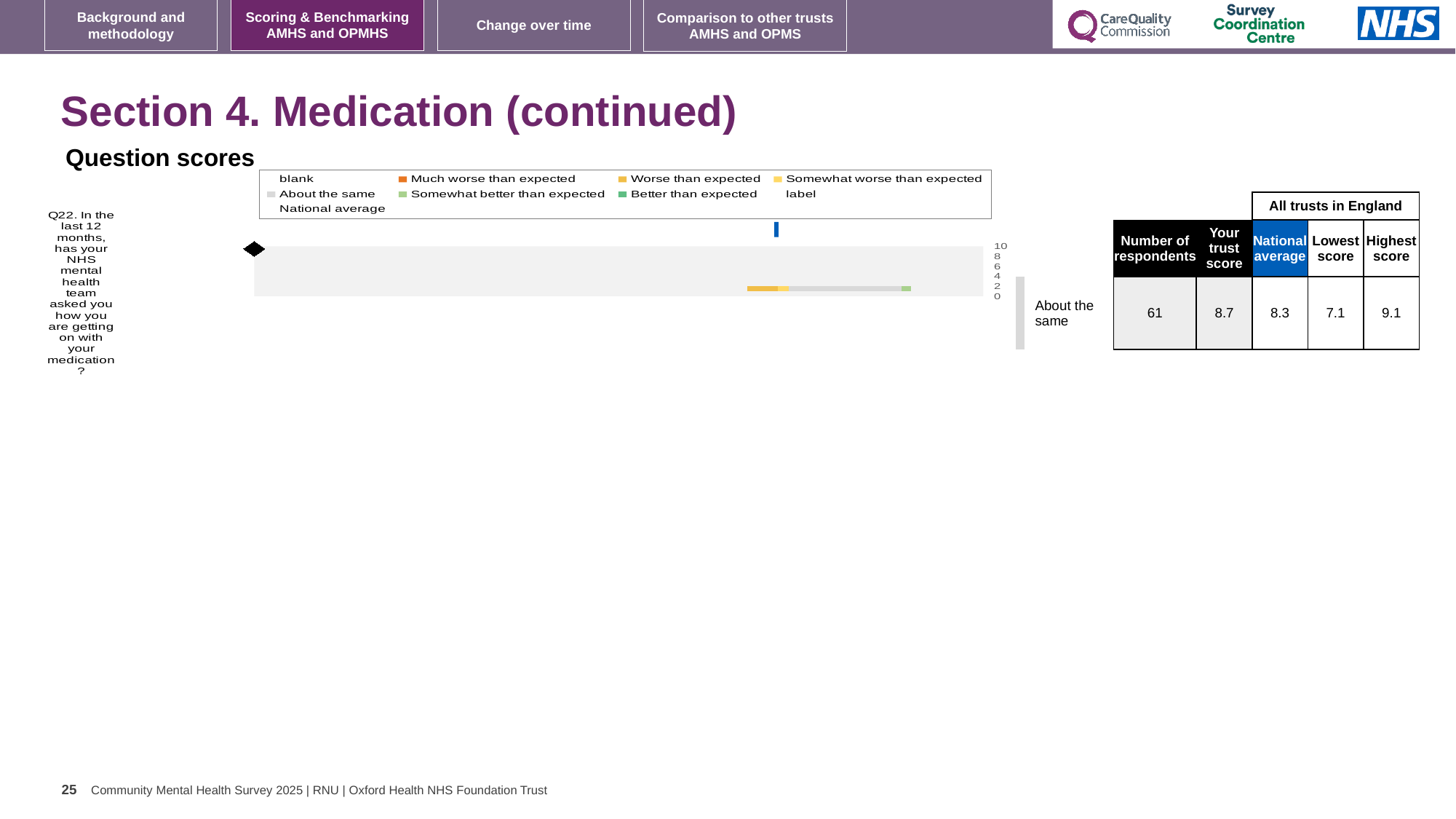
In the table beside the Question scores chart, how many respondents answered Q22? 61 How many survey questions are plotted in the Question scores chart? 1 For Q22, what is the difference between the Highest score and the Lowest score in the table? 2.0 In the legend of the Question scores chart, what colour is used for 'Much worse than expected'? orange In the table beside the Question scores chart, what is the Lowest score for Q22? 7.1 Which benchmark category is shown next to the Q22 bar in the Question scores chart? About the same In the table beside the Question scores chart, what is the 'Your trust score' for Q22? 8.7 How many entries does the legend of the Question scores chart list? 9 In the table beside the Question scores chart, what is the National average for Q22? 8.3 In the table beside the Question scores chart, what is the Highest score for Q22? 9.1 For Q22, which is larger: the trust score or the National average? the trust score What kind of chart is shown under 'Question scores'? bar chart